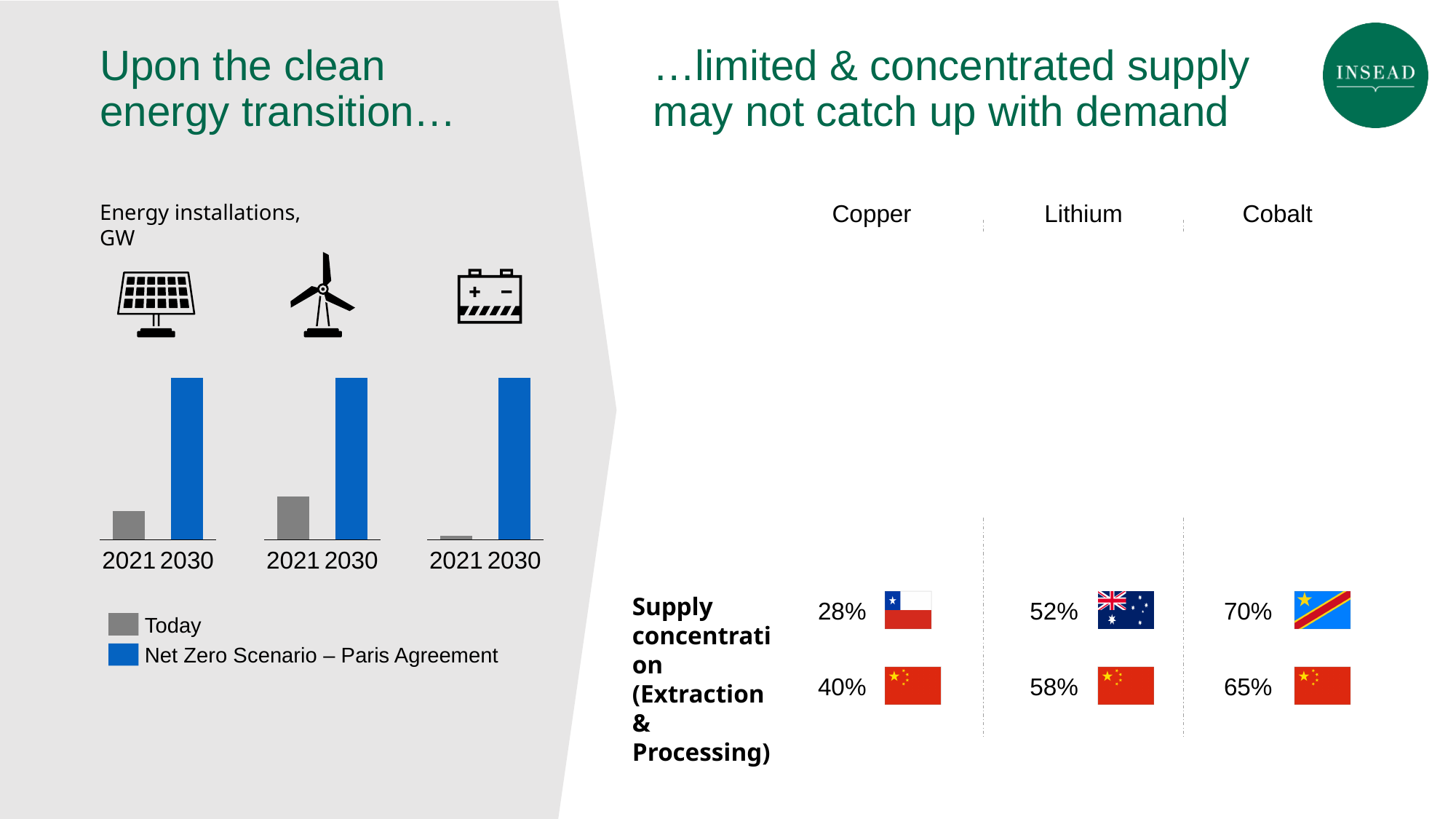
Across the three energy installation charts, which technology has the tallest 2021 bar? wind How many year categories are shown on the x axis of each energy installations chart? 2 Comparing the 2021 bars, is the solar panel bar or the wind turbine bar taller? wind turbine What unit is given for the energy installations chart? GW What are the two legend entries of the energy installations chart? Today; Net Zero Scenario – Paris Agreement In the battery chart, which bar is taller, 2021 or 2030? 2030 In the solar panel chart, which bar is taller, 2021 or 2030? 2030 In the energy installations charts, do the values rise or fall from 2021 to 2030? rise Across the three energy installation charts, which technology has the smallest 2021 bar? battery How many series does the legend of the energy installations chart list? 2 What kind of chart is used to show energy installations in GW on the left of the slide? bar chart